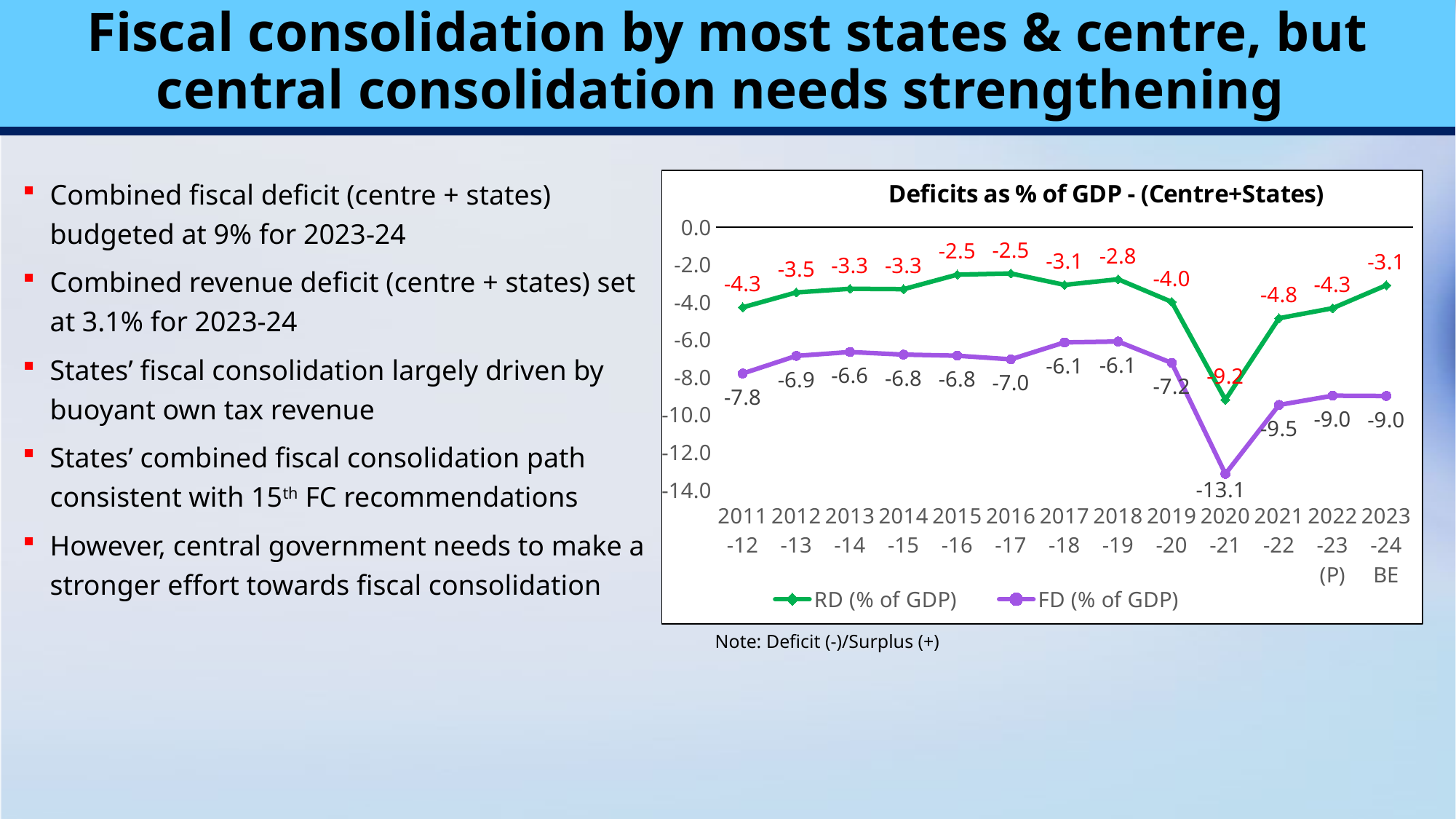
In which year is the RD (% of GDP) value lowest? 2020-21 What is the FD (% of GDP) value for 2020-21? -13.1 In which year is the FD (% of GDP) value lowest? 2020-21 What is the FD (% of GDP) value for 2011-12? -7.8 How many series does the legend list in the chart? 2 How many years are plotted along the x axis of the chart? 13 What type of chart is shown on the slide? Line chart What is the title of the chart? Deficits as % of GDP - (Centre+States) Which is larger, the RD (% of GDP) value for 2018-19 or for 2019-20? 2018-19 What is the RD (% of GDP) value for 2023-24 BE? -3.1 What is the difference between the FD (% of GDP) and RD (% of GDP) values for 2020-21? 3.9 What is the RD (% of GDP) value for 2015-16? -2.5